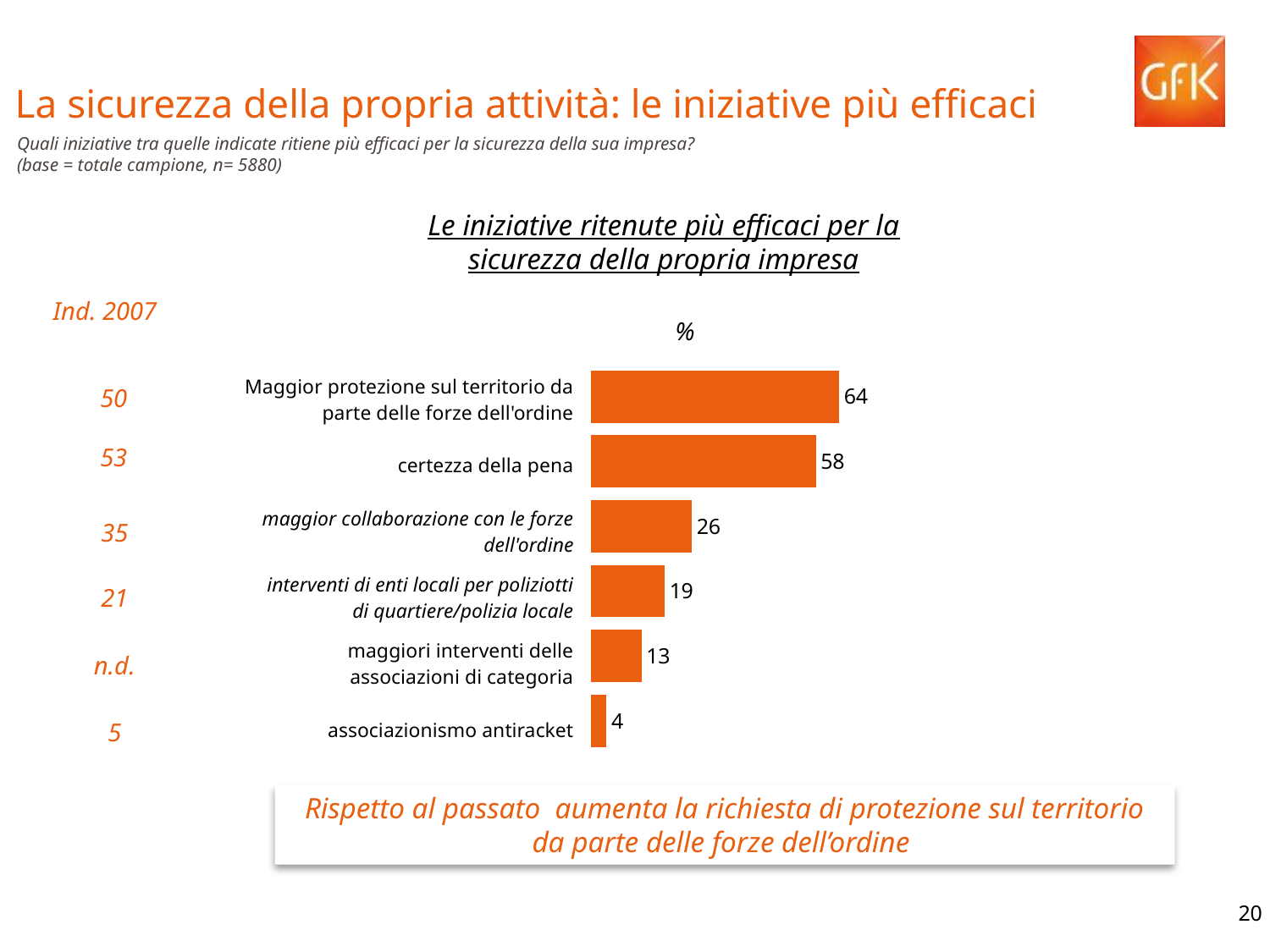
What is the value for 'maggiori interventi delle associazioni di categoria'? 13 Which is larger: the value for 'maggior collaborazione con le forze dell'ordine' or for 'maggiori interventi delle associazioni di categoria'? maggior collaborazione con le forze dell'ordine How many categories are shown in the chart? 6 What kind of chart is shown on the slide? bar chart What colour are the bars in the chart? orange What is the value for 'certezza della pena'? 58 What is the difference between the values for 'Maggior protezione sul territorio da parte delle forze dell'ordine' and 'certezza della pena'? 6 What is the title of the chart? Le iniziative ritenute più efficaci per la sicurezza della propria impresa What is the value for 'associazionismo antiracket'? 4 Which category has the lowest value? associazionismo antiracket What is the difference between the values for 'maggior collaborazione con le forze dell'ordine' and 'interventi di enti locali per poliziotti di quartiere/polizia locale'? 7 Which category has the highest value? Maggior protezione sul territorio da parte delle forze dell'ordine